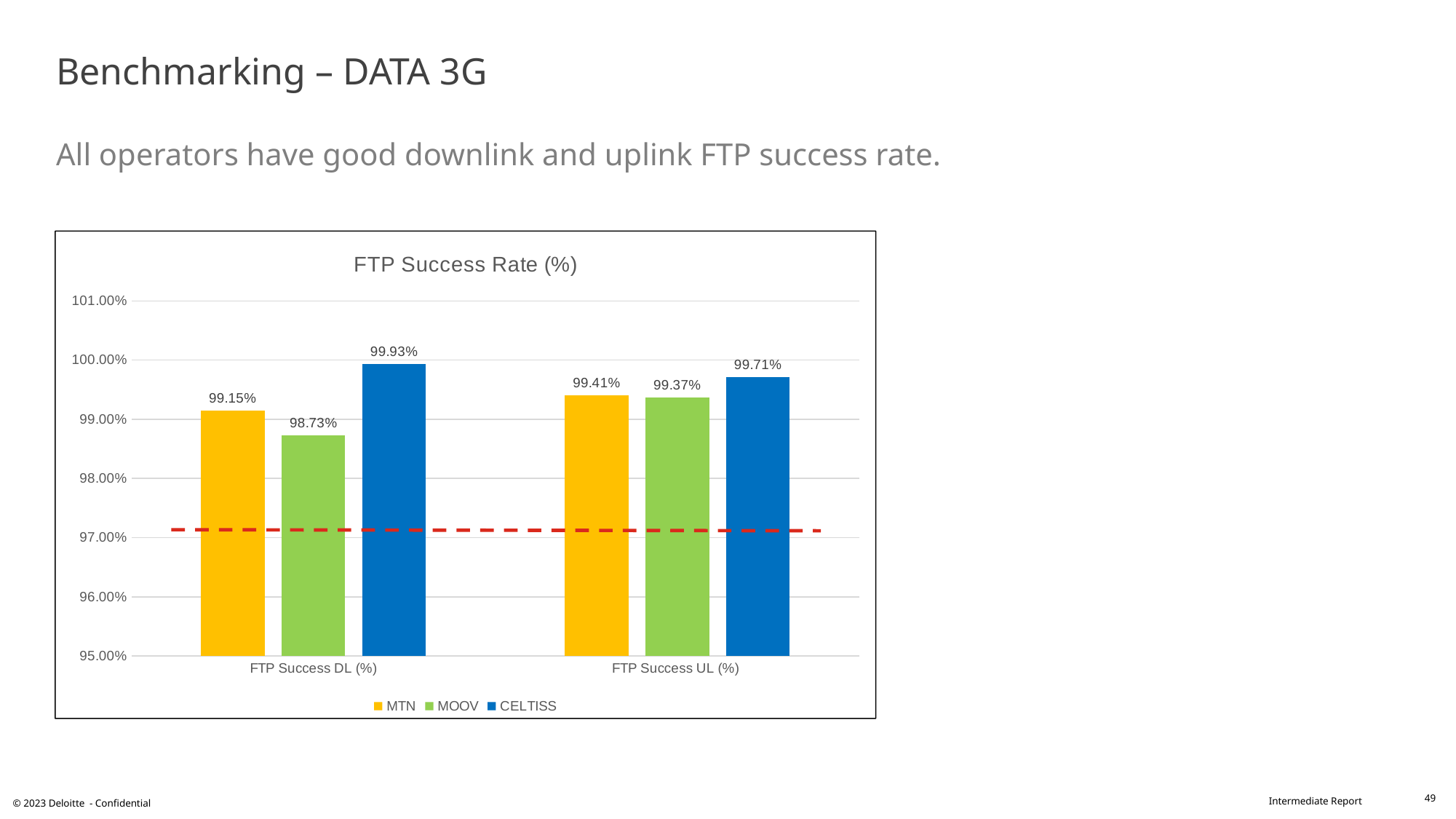
Which is larger: MTN's FTP Success DL (%) or MTN's FTP Success UL (%)? FTP Success UL (%) What is the difference between CELTISS and MOOV for FTP Success DL (%)? 1.20% How many series does the legend list? 3 What is the FTP Success DL (%) value for MOOV? 98.73% What kind of chart is shown on the slide? Bar chart What is the FTP Success UL (%) value for CELTISS? 99.71% Which operator has the lowest FTP Success DL (%)? MOOV What is the title of the chart? FTP Success Rate (%) Is the FTP Success DL (%) value for MOOV greater or less than 99.00%? less Which operator has the highest FTP Success DL (%)? CELTISS How many categories are shown on the x axis? 2 What is the FTP Success DL (%) value for MTN? 99.15%